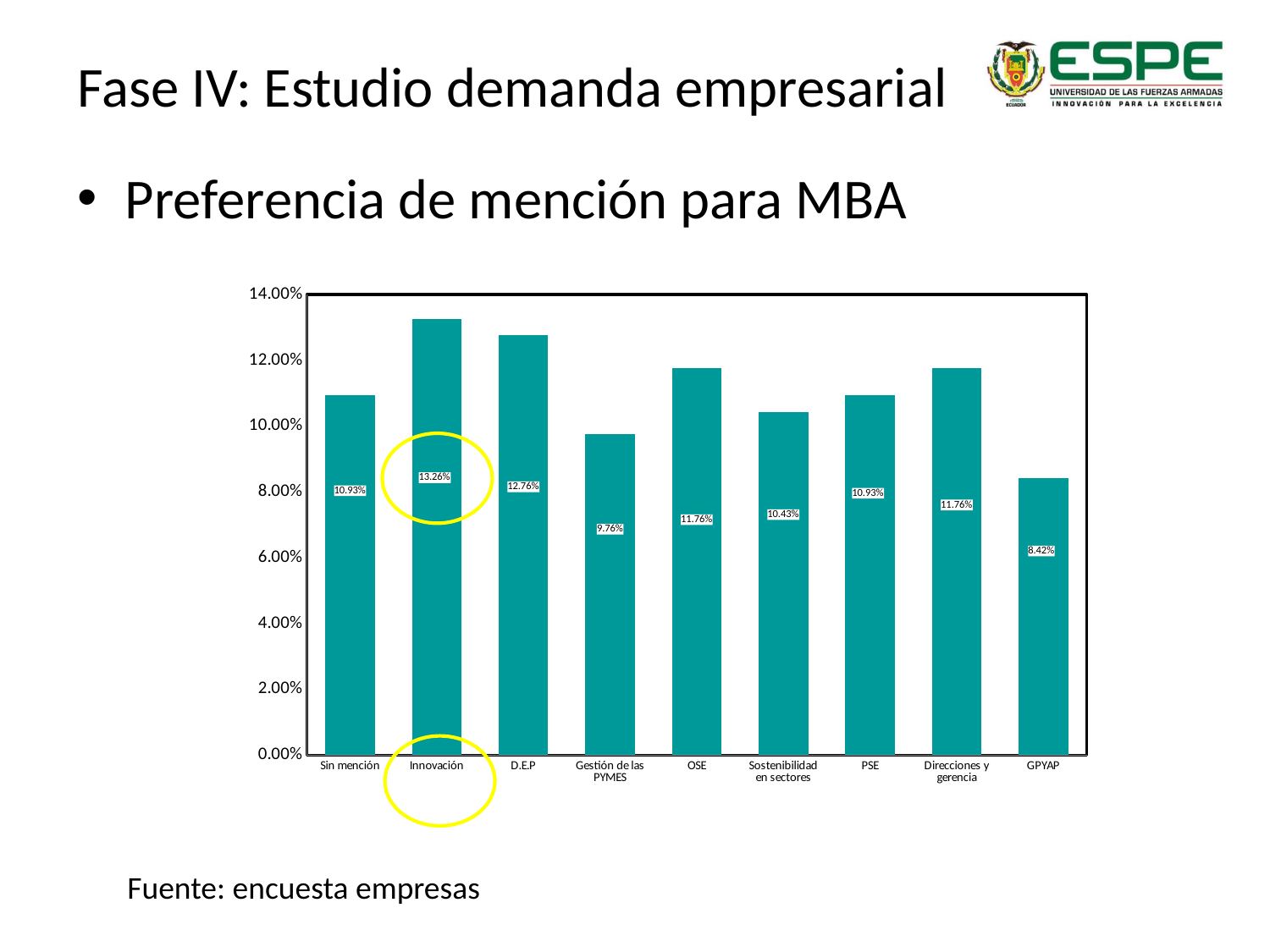
What is the value for Gestión de las PYMES? 9.76% Is the value for D.E.P greater or less than 12.00%? greater What kind of chart is shown on the slide? Bar chart Which category has the highest value? Innovación How many categories are shown on the x axis? 9 What is the difference between the values for Innovación and D.E.P? 0.50% Which category has the lowest value? GPYAP What is the value for Sostenibilidad en sectores? 10.43% What is the value for GPYAP? 8.42% Which is larger, the value for OSE or the value for PSE? OSE Which category is highlighted with a yellow circle? Innovación What is the value for Innovación? 13.26%